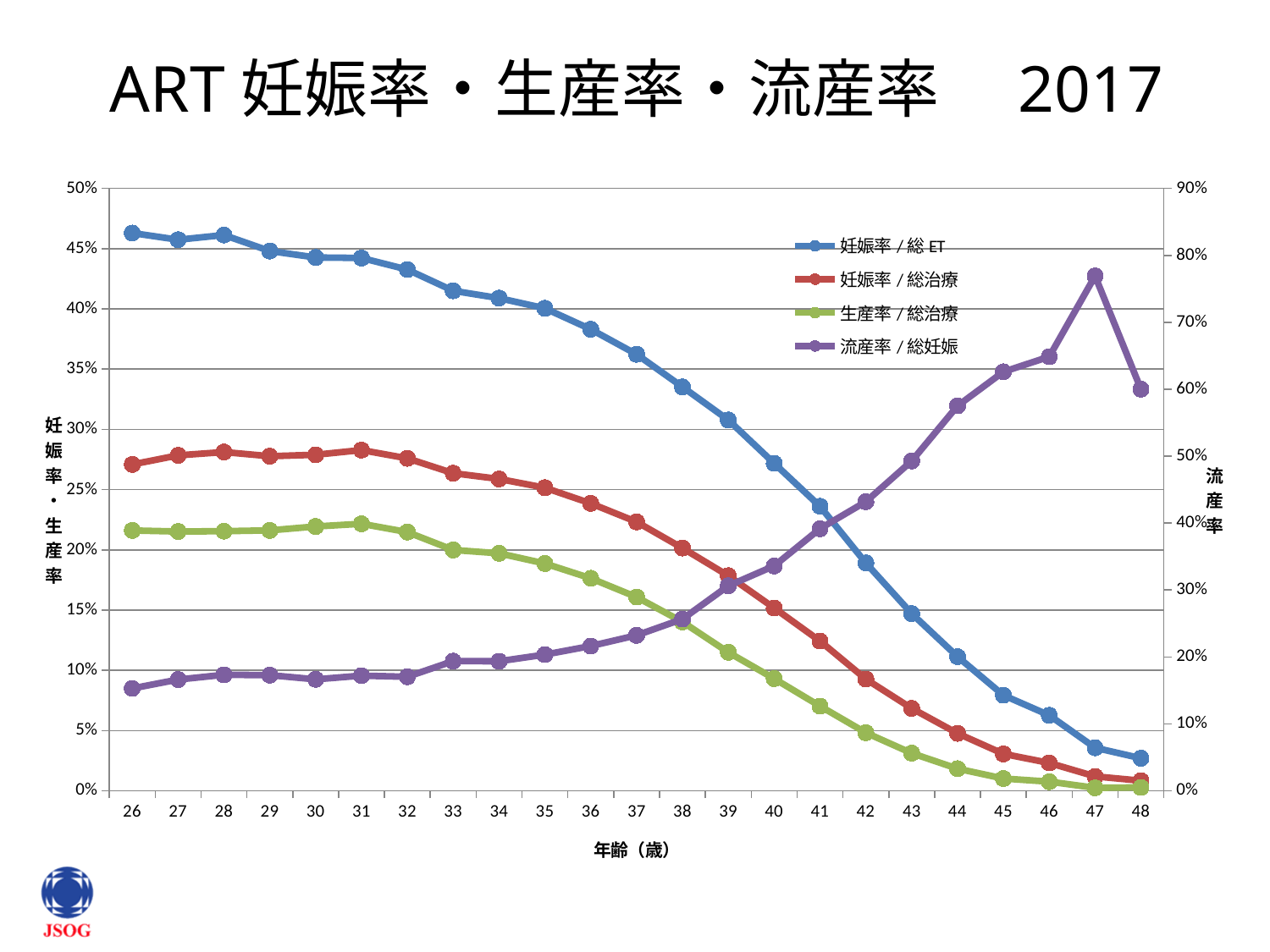
Is the value of 妊娠率 / 総 ET at age 40 greater or less than 25%? greater What kind of chart is shown on the slide? line chart How many age categories are plotted along the x axis? 23 What is the label of the x axis? 年齢（歳） At which age is 流産率 / 総妊娠 highest? 47 How many series does the legend list? 4 What is the title of the chart on the slide? ART 妊娠率・生産率・流産率 2017 Is the value of 生産率 / 総治療 at age 44 greater or less than 5%? less Is the value of 流産率 / 総妊娠 at age 47 greater or less than 70%? greater At age 40, which is larger: 妊娠率 / 総治療 or 生産率 / 総治療? 妊娠率 / 総治療 At which age is 妊娠率 / 総 ET lowest? 48 Does 妊娠率 / 総 ET rise or fall as age increases from 26 to 48? fall